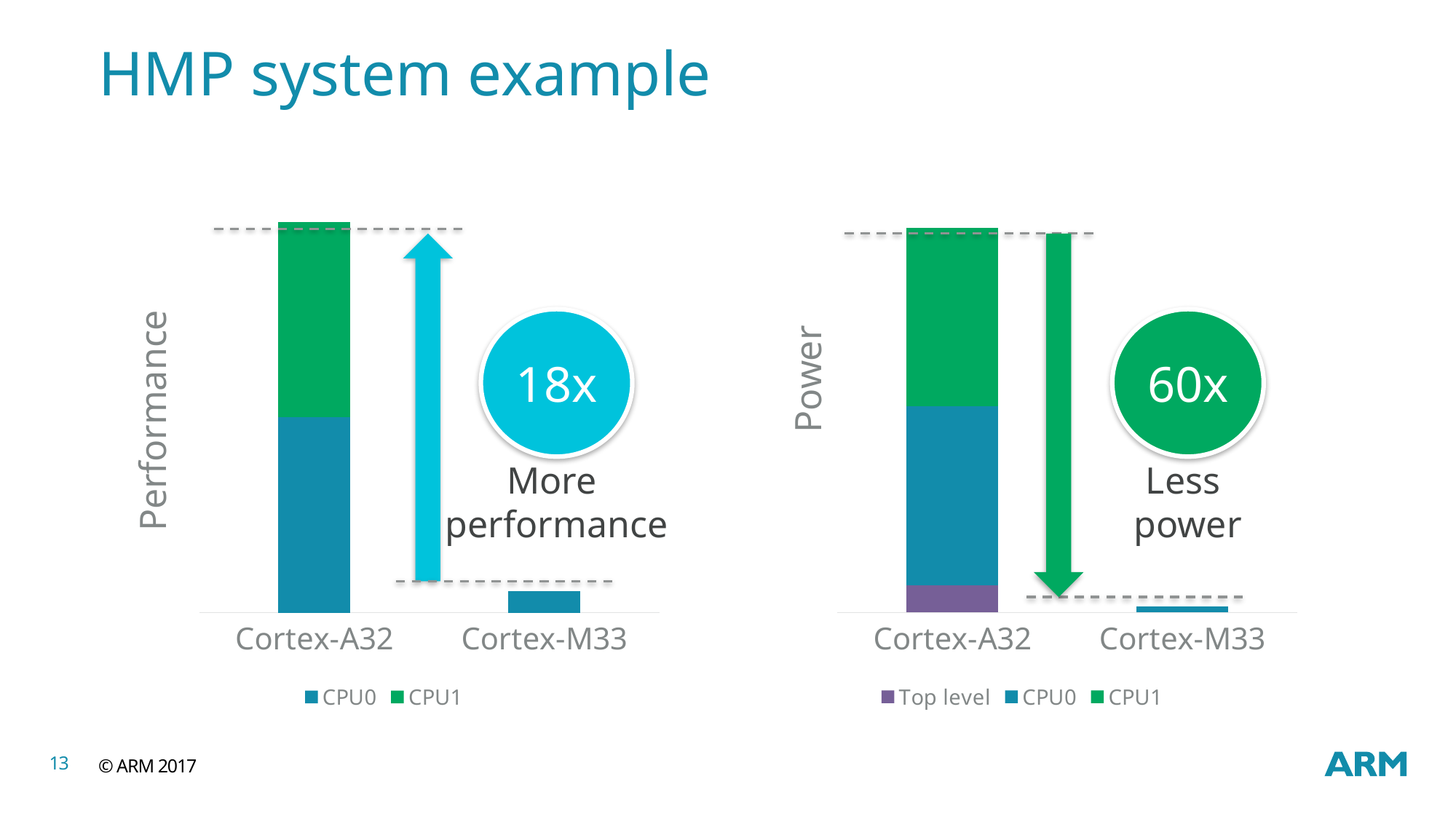
How many series does the legend of the right chart (Power) list? 3 What series does the legend of the right chart (Power) list that the left chart's legend does not? Top level In the left chart (Performance), which category has the shorter bar, Cortex-A32 or Cortex-M33? Cortex-M33 In the left chart (Performance), how many categories are shown on the x axis? 2 In the right chart (Power), how many categories are shown on the x axis? 2 What multiplier is shown in the circle annotation next to the left chart (Performance)? 18x What kind of chart is the left chart (Performance)? Stacked bar chart How many series does the legend of the left chart (Performance) list? 2 In the left chart (Performance), which category has the tallest stacked bar? Cortex-A32 In the right chart (Power), which category has the taller stacked bar, Cortex-A32 or Cortex-M33? Cortex-A32 In the right chart (Power), which category has the shortest stacked bar? Cortex-M33 What kind of chart is the right chart (Power)? Stacked bar chart